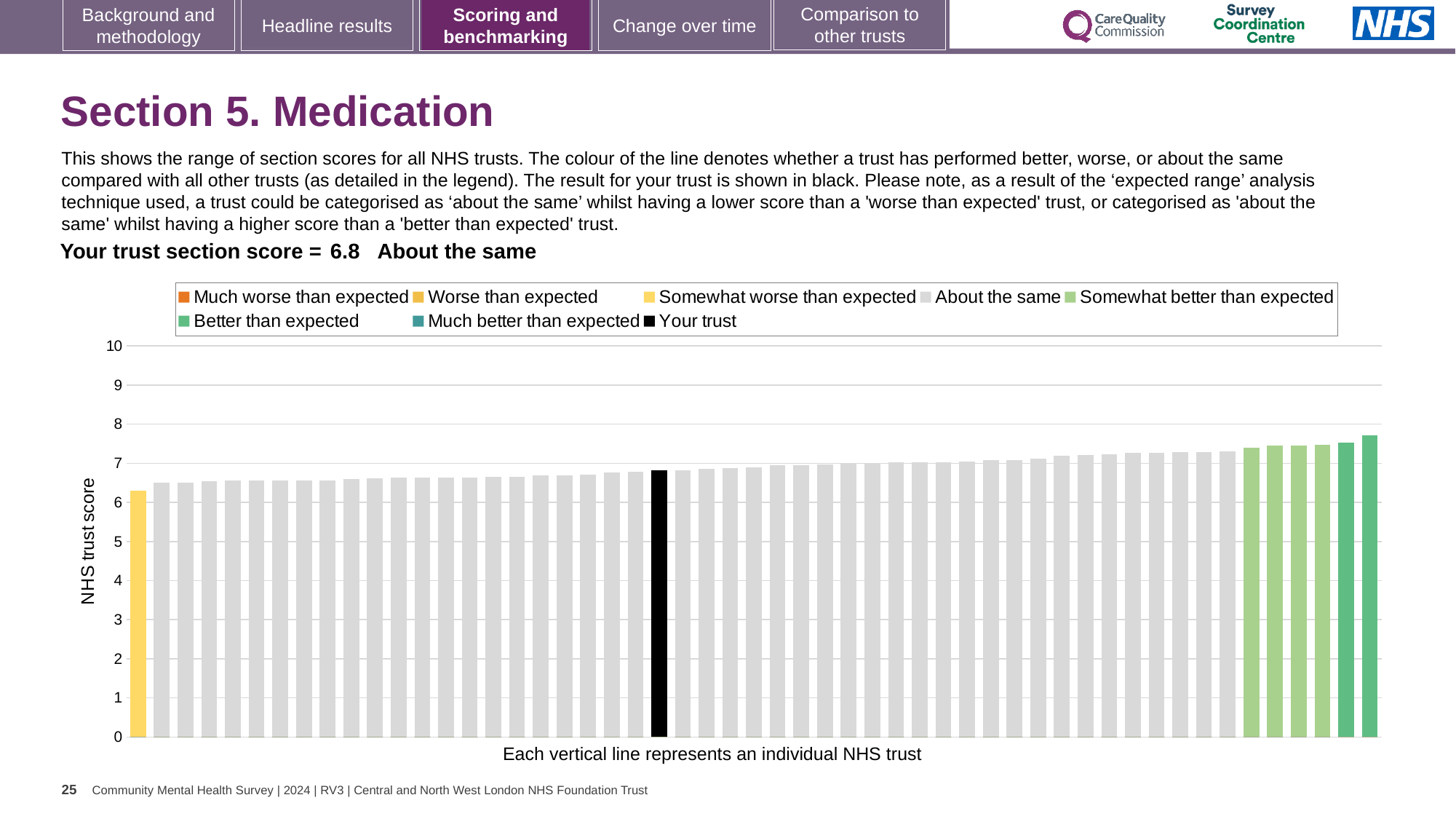
Is the rightmost bar higher or lower than the black bar for your trust? higher Is the value of the leftmost (yellow) bar greater or less than 7? less Do the bar values rise or fall from left to right along the x axis? rise Is the value of the black bar (your trust) greater or less than 6? greater Is the value of the rightmost bar greater or less than 7? greater Which performance category is your trust's section score assigned to? About the same What is the section score for your trust shown on the slide? 6.8 What kind of chart is shown on the slide? bar chart How many entries does the chart legend list? 8 What is the label on the vertical axis of the chart? NHS trust score What colour is the bar representing your trust? black